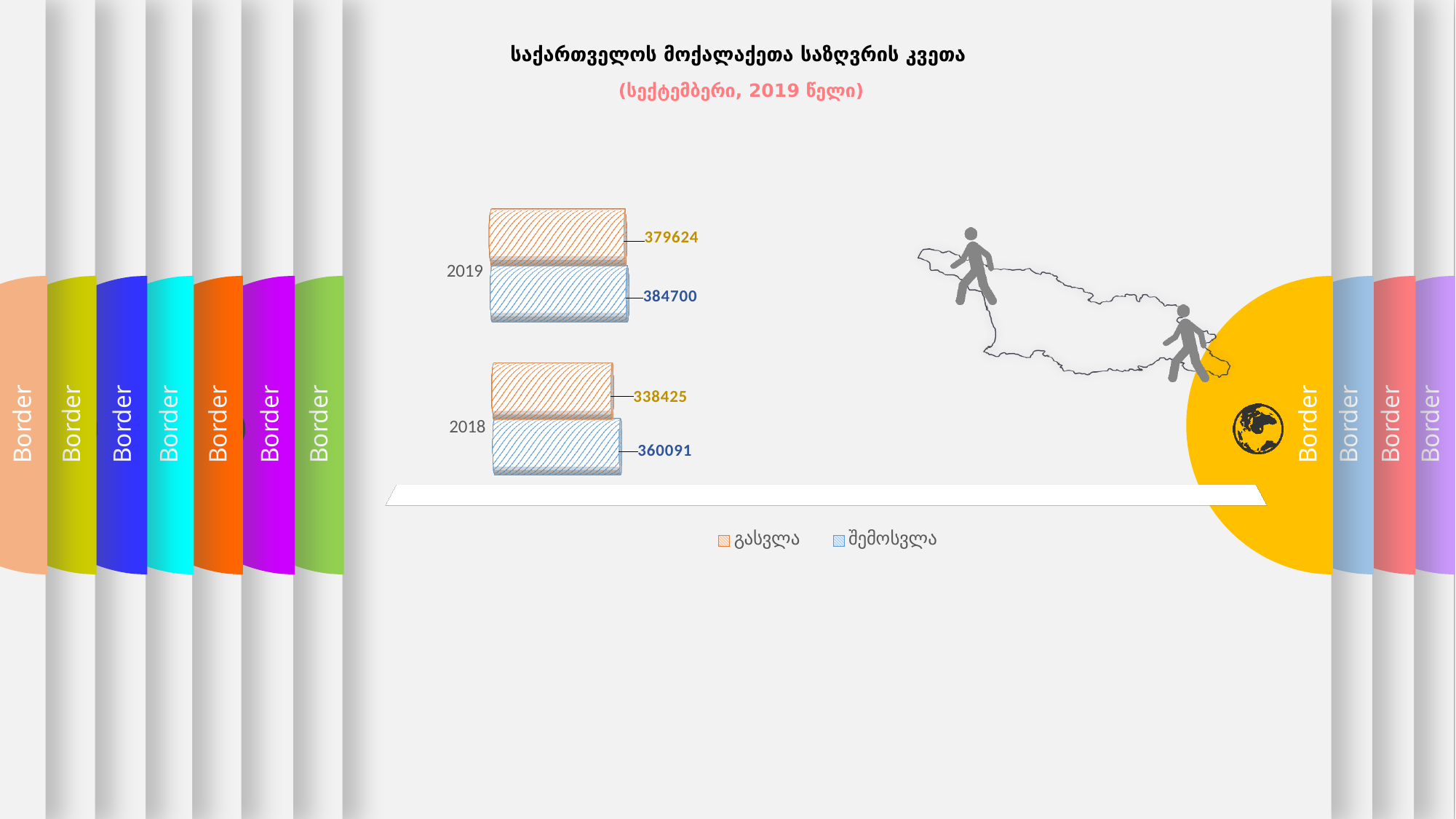
What kind of chart is shown on the slide? Bar chart What is the value for გასვლა in 2019? 379624 How many series does the legend list? 2 In 2019, which is larger: გასვლა or შემოსვლა? შემოსვლა What is the value for გასვლა in 2018? 338425 What is the difference between შემოსვლა and გასვლა in 2018? 21666 What is the value for შემოსვლა in 2019? 384700 What is the value for შემოსვლა in 2018? 360091 What is the difference between the გასვლა values for 2019 and 2018? 41199 Which year has the lower value for გასვლა? 2018 How many years are shown on the chart? 2 Which year has the higher value for შემოსვლა? 2019